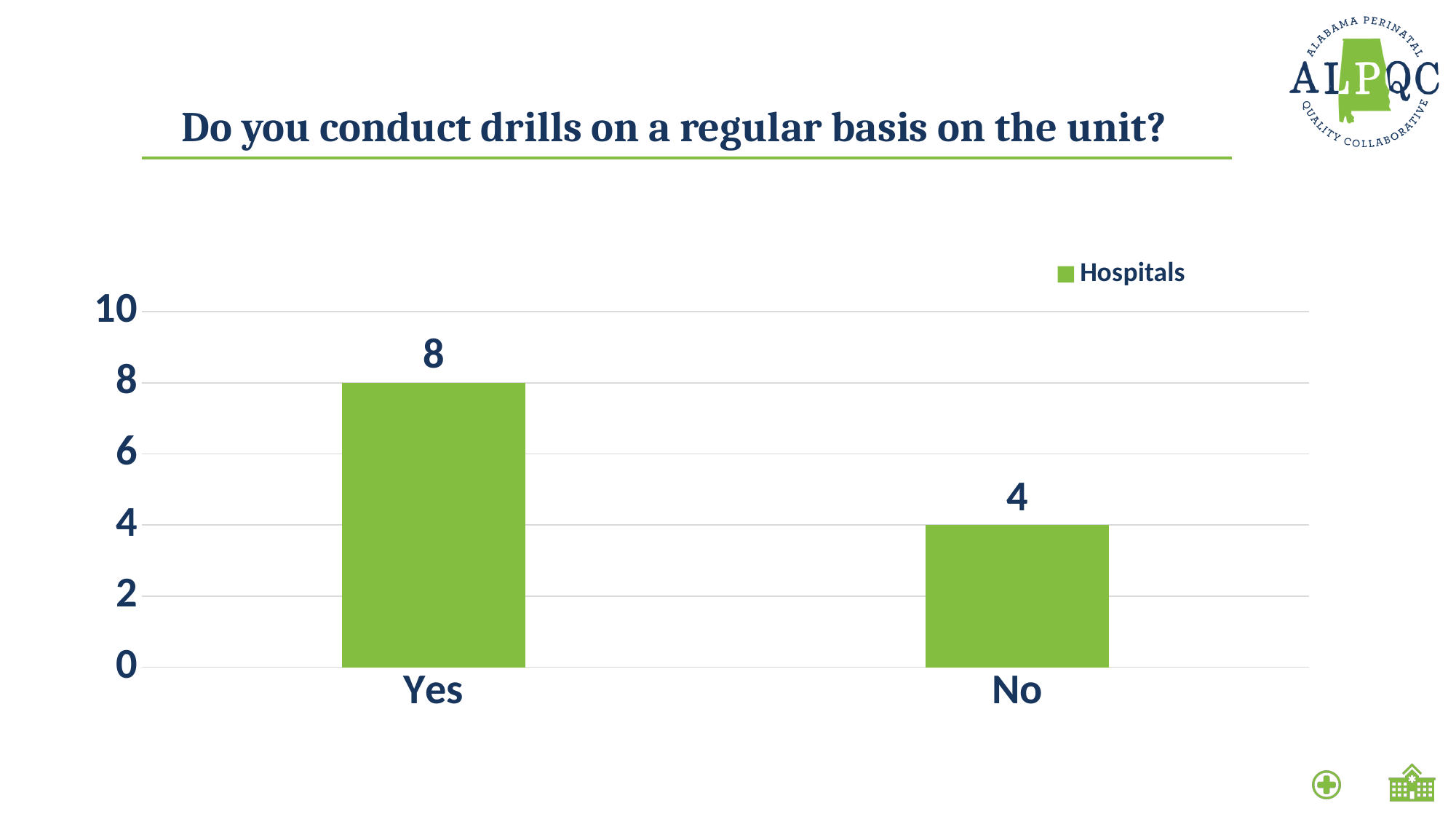
How many hospitals answered No? 4 What is the name of the series in the legend? Hospitals How many hospitals answered Yes? 8 How many categories are shown on the x axis? 2 How many series does the legend list? 1 What is the total of the Yes and No values? 12 Which category has the lowest value? No What is the difference between the Yes and No values? 4 What kind of chart is shown on the slide? Bar chart Which category has the highest value? Yes Which is larger, the value for Yes or the value for No? Yes Is the value for Yes greater or less than 6? greater